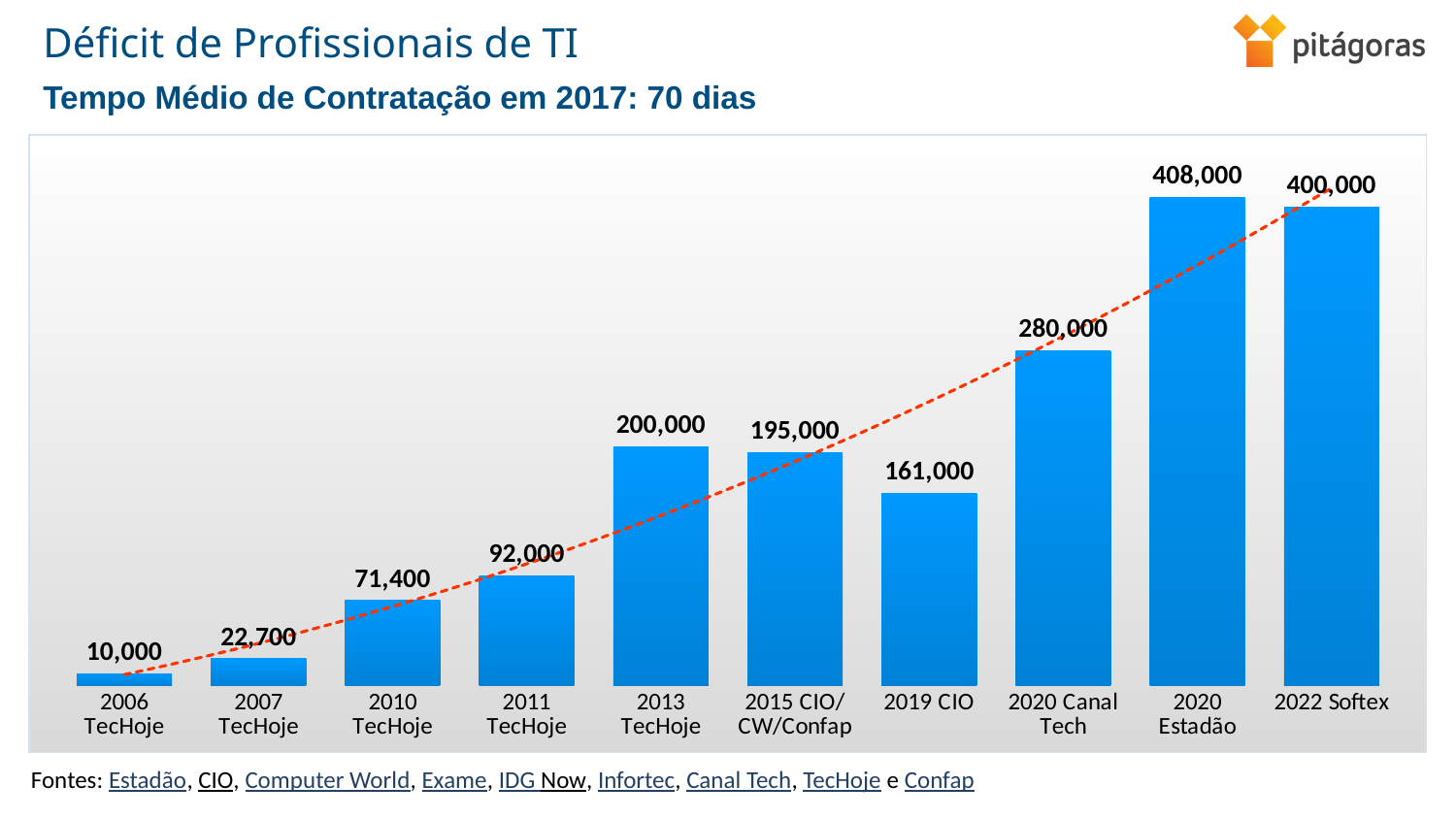
Which category has the highest value? 2020 Estadão What is the value for 2006 TecHoje? 10,000 What is the value for 2019 CIO? 161,000 What kind of chart is this? bar chart Do the values generally rise or fall from left to right along the x axis? rise How many bars are shown in the chart? 10 What is the value for 2020 Canal Tech? 280,000 Which category has the lowest value? 2006 TecHoje What is the subtitle shown above the chart? Tempo Médio de Contratação em 2017: 70 dias What is the difference between the values for 2020 Estadão and 2022 Softex? 8,000 What is the difference between the values for 2011 TecHoje and 2010 TecHoje? 20,600 Which is larger, the value for 2013 TecHoje or the value for 2015 CIO/CW/Confap? 2013 TecHoje